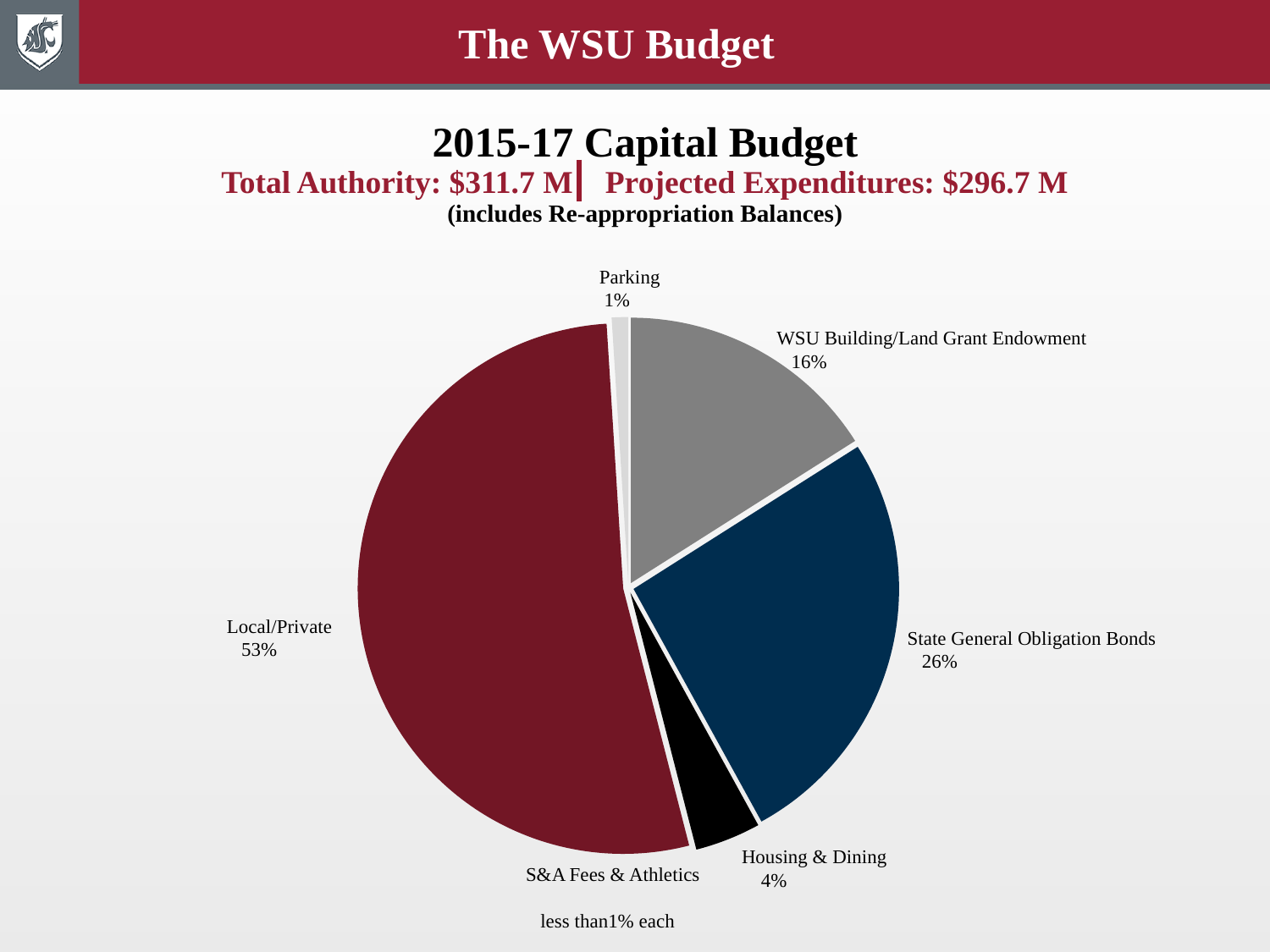
What share is given for S&A Fees & Athletics? less than 1% each Which category has the largest slice of the pie chart? Local/Private Which is larger: State General Obligation Bonds or WSU Building/Land Grant Endowment? State General Obligation Bonds What share of the 2015-17 Capital Budget pie chart is Local/Private? 53% What is the title of the chart on the slide? 2015-17 Capital Budget What share of the pie is Parking? 1% What percentage does the State General Obligation Bonds slice represent? 26% What share is shown for WSU Building/Land Grant Endowment? 16% How many percentage points larger is Local/Private than State General Obligation Bonds? 27 percentage points What is the difference in percentage points between State General Obligation Bonds and WSU Building/Land Grant Endowment? 10 percentage points What percentage is labelled for Housing & Dining? 4% What kind of chart is shown on the slide? Pie chart